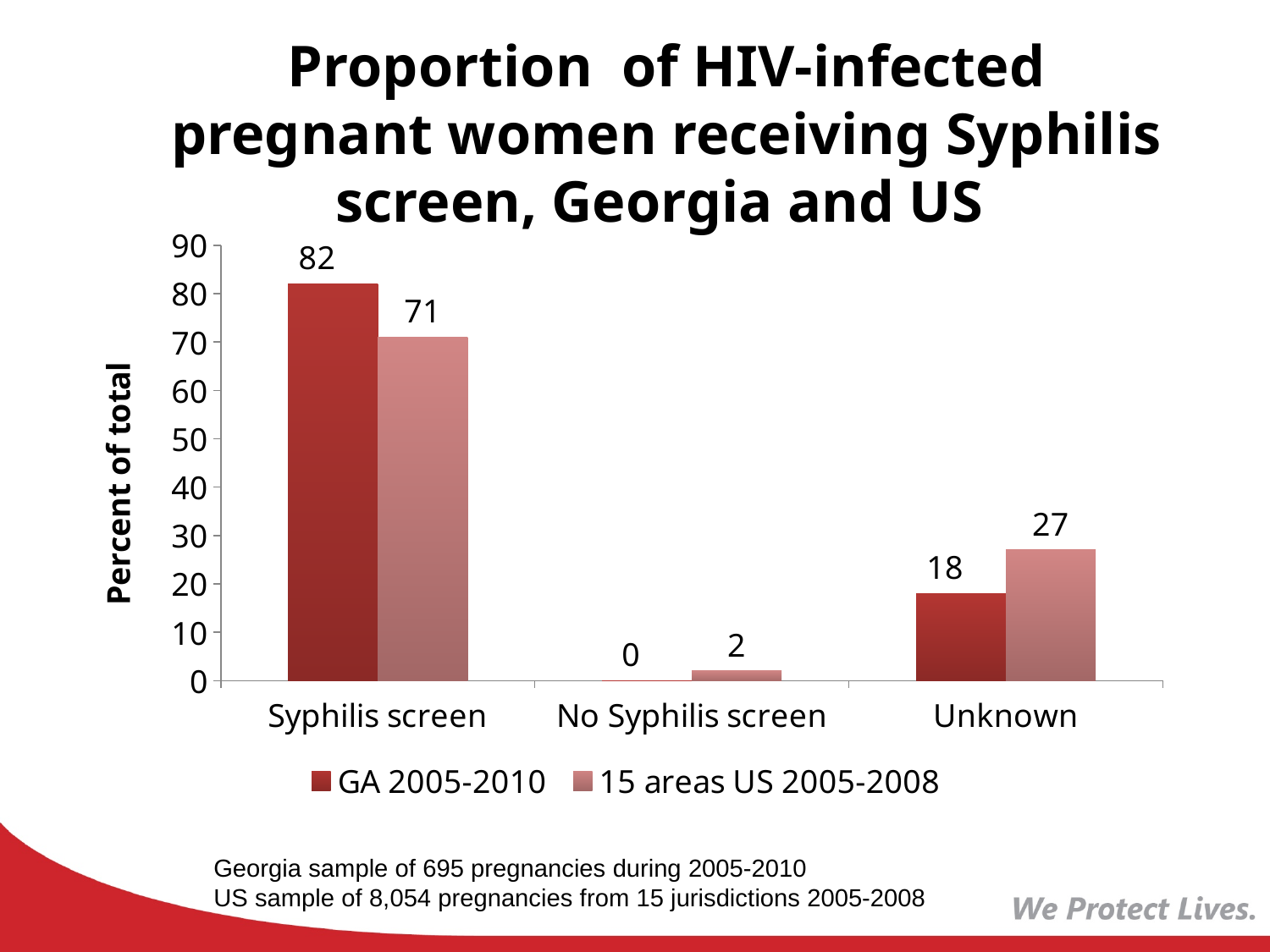
What is the difference between the GA 2005-2010 and 15 areas US 2005-2008 values in the Syphilis screen category? 11 What kind of chart is shown on the slide? Bar chart What is the label of the y axis? Percent of total Which category has the highest value for GA 2005-2010? Syphilis screen What is the value for GA 2005-2010 in the No Syphilis screen category? 0 How many categories are shown on the x axis? 3 What is the value for 15 areas US 2005-2008 in the Syphilis screen category? 71 What is the value for GA 2005-2010 in the Syphilis screen category? 82 Which category has the lowest value for 15 areas US 2005-2008? No Syphilis screen How many series does the legend list? 2 In the Unknown category, which series has the larger value, GA 2005-2010 or 15 areas US 2005-2008? 15 areas US 2005-2008 What is the value for 15 areas US 2005-2008 in the Unknown category? 27